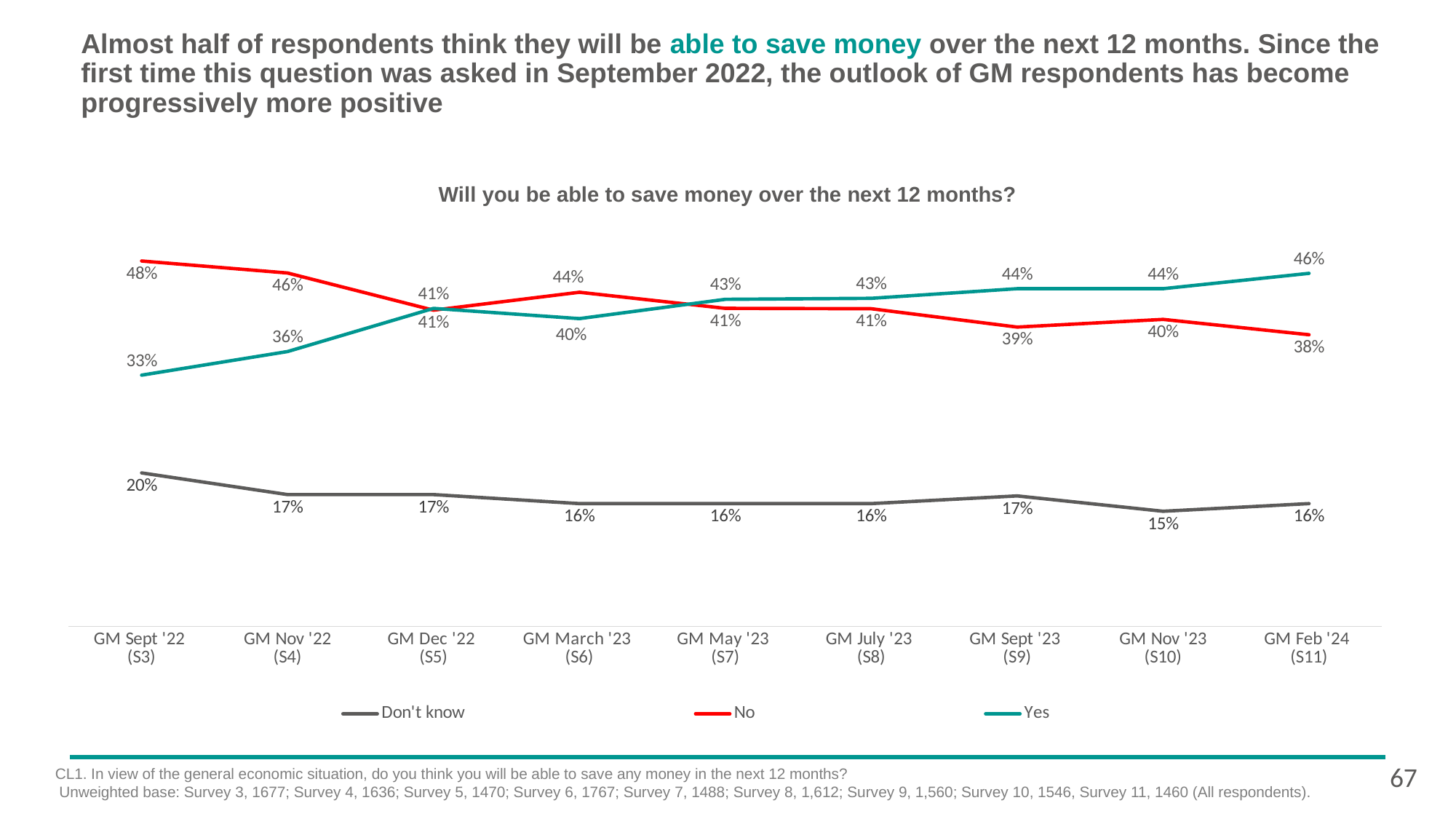
What is the difference between the Yes and No values at GM Feb '24 (S11)? 8 percentage points How many survey points are shown on the x axis? 9 What colour is the line for the No series? Red What kind of chart is shown on the slide? Line chart What is the value for Yes at GM Feb '24 (S11)? 46% What is the value for No at GM Sept '22 (S3)? 48% At GM March '23 (S6), which is larger, Yes or No? No How many series does the legend list? 3 At which survey point is the Yes series at its lowest? GM Sept '22 (S3) What is the value for Don't know at GM Nov '23 (S10)? 15% Does the Yes series generally rise or fall from GM Sept '22 to GM Feb '24? Rise At which survey point is the No series at its highest? GM Sept '22 (S3)